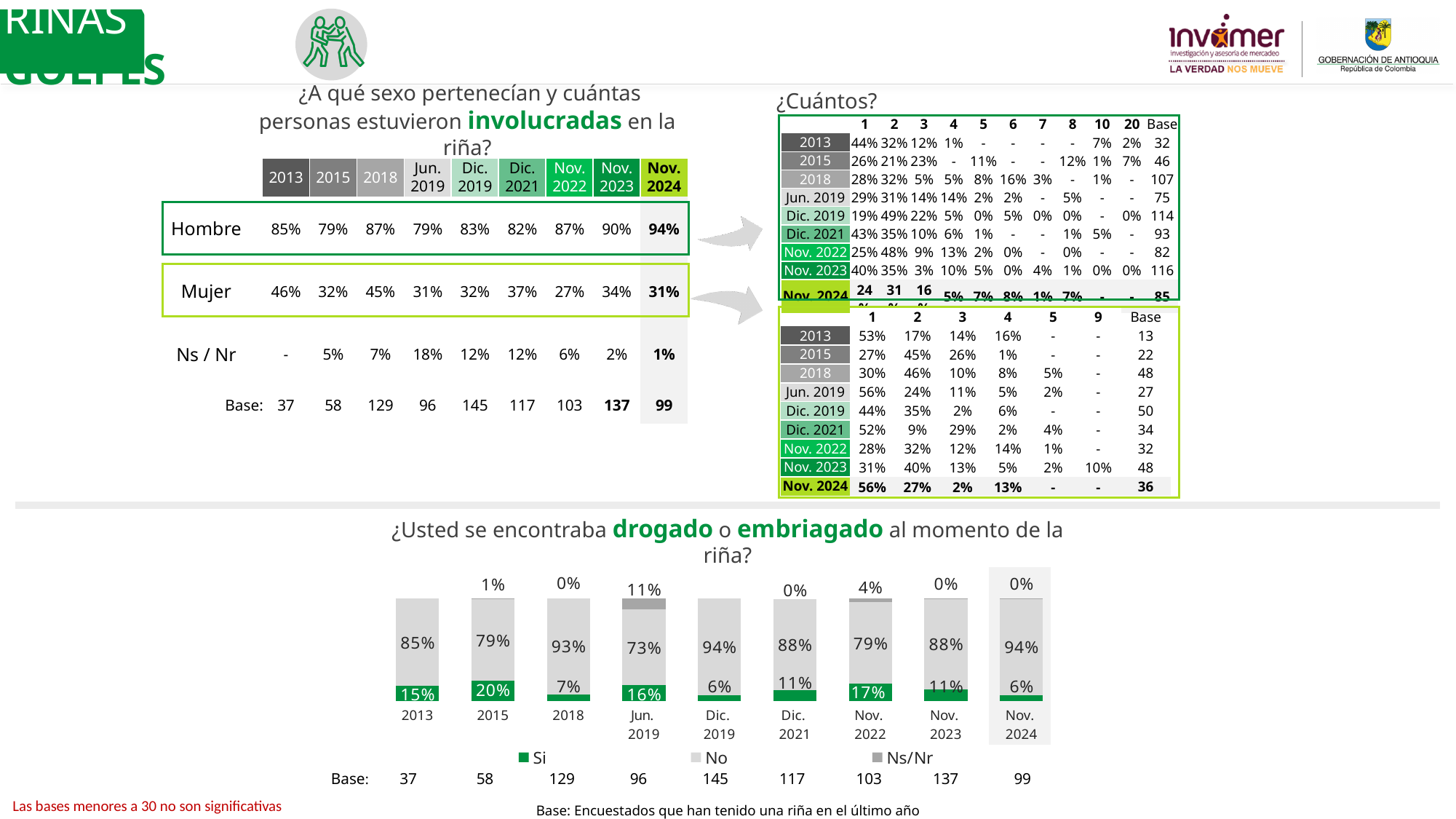
In the chart '¿Usted se encontraba drogado o embriagado al momento de la riña?', what percentage answered 'Si' in Nov. 2024? 6% In the chart '¿Usted se encontraba drogado o embriagado al momento de la riña?', which colour represents the 'Si' series? Green In the chart '¿Usted se encontraba drogado o embriagado al momento de la riña?', which year has the highest 'Si' percentage? 2015 In the chart '¿Usted se encontraba drogado o embriagado al momento de la riña?', how many time periods are shown on the x axis? 9 What type of chart is used for '¿Usted se encontraba drogado o embriagado al momento de la riña?'? Stacked bar chart In the chart '¿Usted se encontraba drogado o embriagado al momento de la riña?', what percentage answered 'No' in Jun. 2019? 73% In the chart '¿Usted se encontraba drogado o embriagado al momento de la riña?', what is the difference between the 'Si' percentage in 2015 and in Nov. 2024? 14% In the chart '¿Usted se encontraba drogado o embriagado al momento de la riña?', what is the 'No' percentage for Dic. 2021? 88% In the chart '¿Usted se encontraba drogado o embriagado al momento de la riña?', is the 'Si' percentage higher in 2013 or in 2018? 2013 In the chart '¿Usted se encontraba drogado o embriagado al momento de la riña?', how many series does the legend list? 3 In the chart '¿Usted se encontraba drogado o embriagado al momento de la riña?', which period has the highest 'Ns/Nr' percentage? Jun. 2019 In the chart '¿Usted se encontraba drogado o embriagado al momento de la riña?', what is the 'Ns/Nr' value for Nov. 2022? 4%